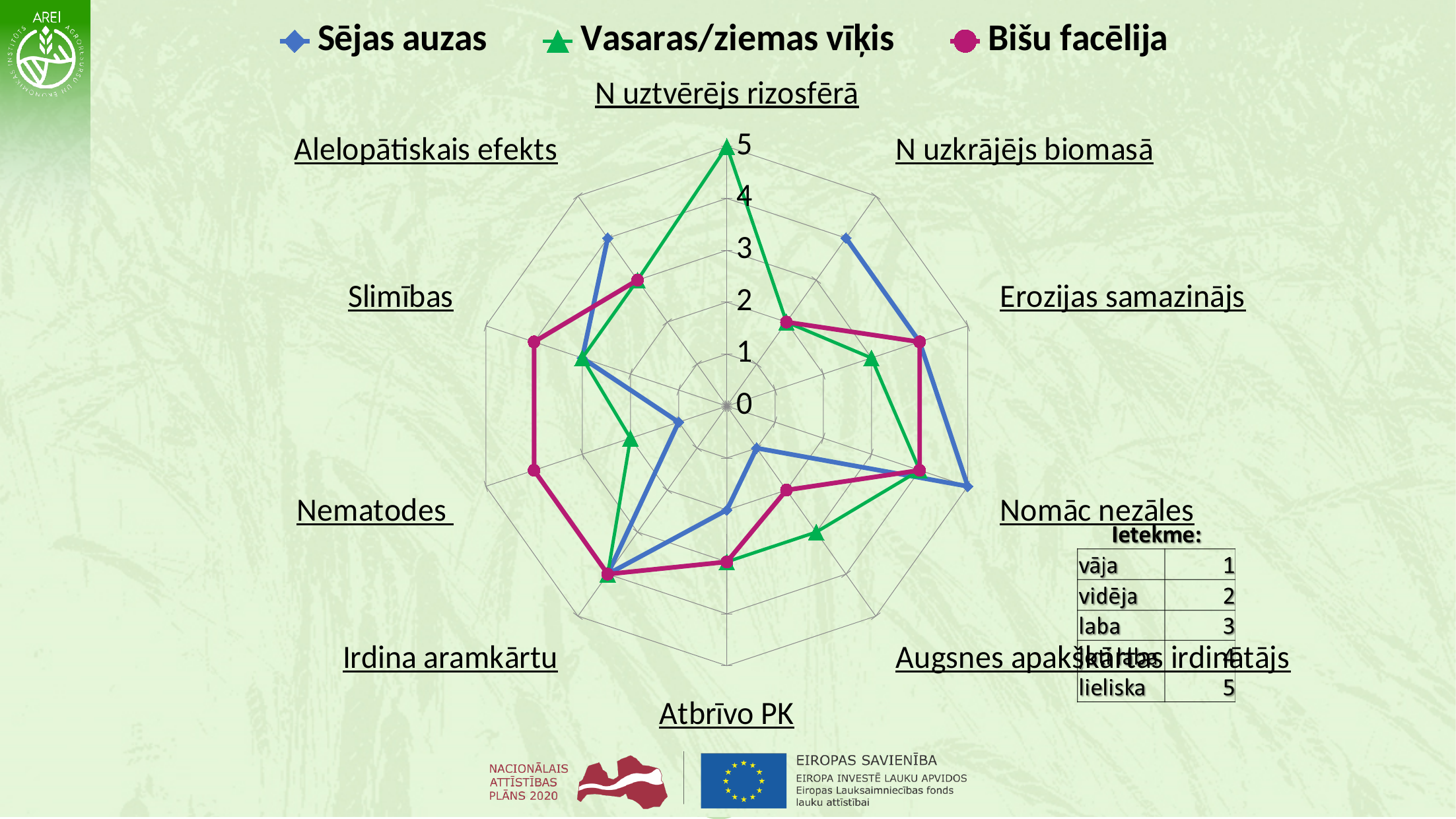
What is the maximum value shown on the radar chart's scale? 5 Is the value of Sējas auzas for Nematodes greater or less than 3? less How many axes (categories) does the radar chart have? 10 Is the value of Sējas auzas for Augsnes apakškārtas irdinātājs greater or less than 3? less What kind of chart is shown on the slide? radar chart Which series has the higher value for Nematodes, Bišu facēlija or Sējas auzas? Bišu facēlija What is the value of Sējas auzas for Nomāc nezāles? 5 How many series does the legend list? 3 What is the value of Vasaras/ziemas vīķis for N uztvērējs rizosfērā? 5 Is the value of Bišu facēlija for Slimības greater or less than 3? greater What is the value of Bišu facēlija for Nematodes? 4